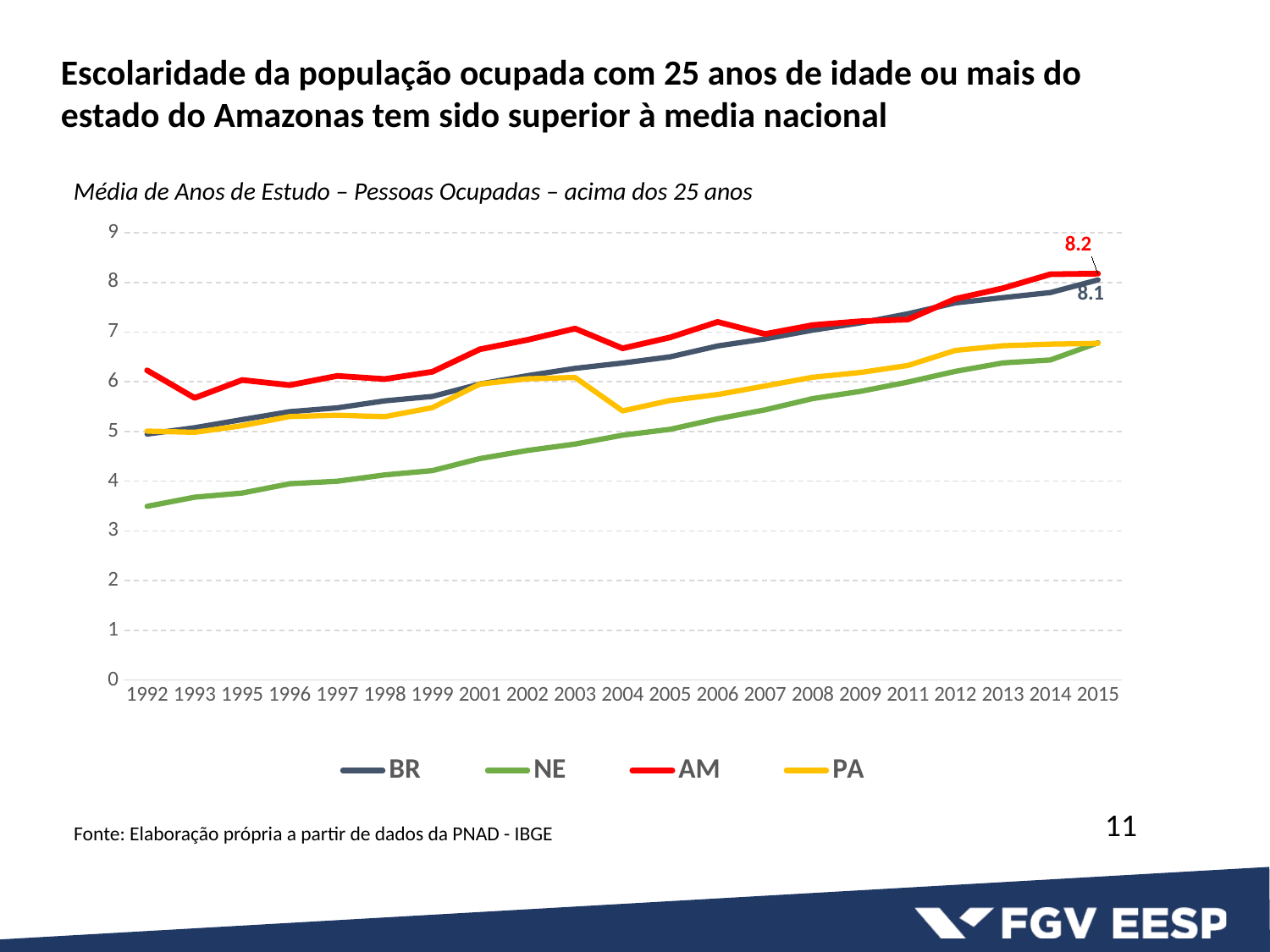
What kind of chart is shown on the slide? line chart Which series has the higher value in 2015, AM or BR? AM Is the value for PA in 2004 greater or less than 6? less Is the value for NE in 1992 greater or less than 4? less What is the difference between the AM and BR values in 2015? 0.1 What colour is the AM line? red How many series does the legend list? 4 Does the NE series generally rise or fall from 1992 to 2015? rise What is the value for AM in 2015? 8.2 What is the value for BR in 2015? 8.1 Which series has the lowest value in 1992? NE How many years are shown on the x axis? 21